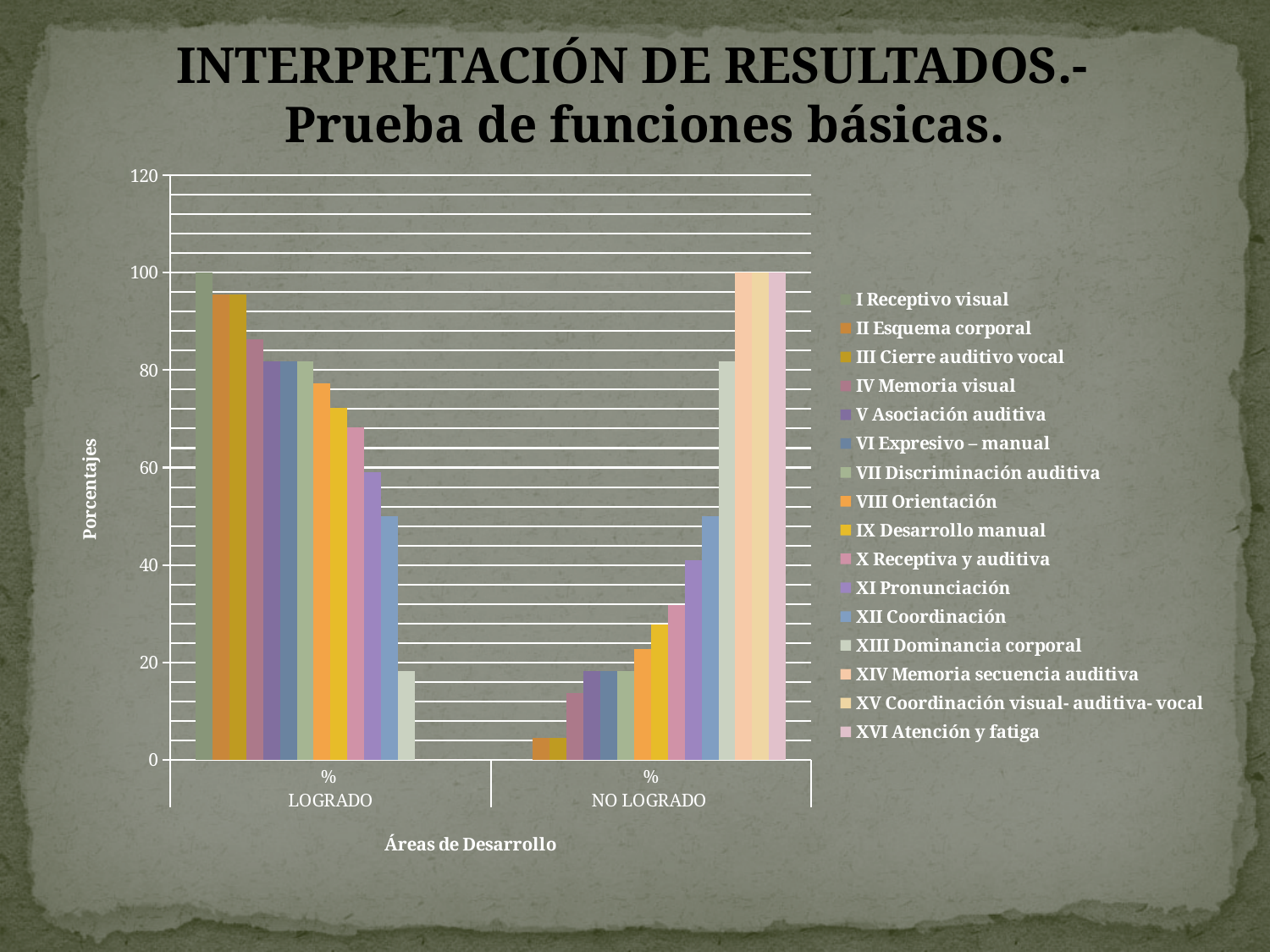
How many categories are shown on the x axis of the chart? 2 What kind of chart is shown on the slide? bar chart Is the value for II Esquema corporal in the % NO LOGRADO category greater or less than 20? less Is the value for XIII Dominancia corporal in the % NO LOGRADO category greater or less than 80? greater Is the value for XIII Dominancia corporal in the % LOGRADO category greater or less than 20? less What is the value for XVI Atención y fatiga in the % NO LOGRADO category? 100 What is the value for I Receptivo visual in the % LOGRADO category? 100 What is the title of the vertical axis of the chart? Porcentajes How many series does the chart's legend list? 16 Which is larger for XIII Dominancia corporal: the % LOGRADO value or the % NO LOGRADO value? % NO LOGRADO Which series has the highest value in the % LOGRADO category? I Receptivo visual What is the title of the horizontal axis of the chart? Áreas de Desarrollo